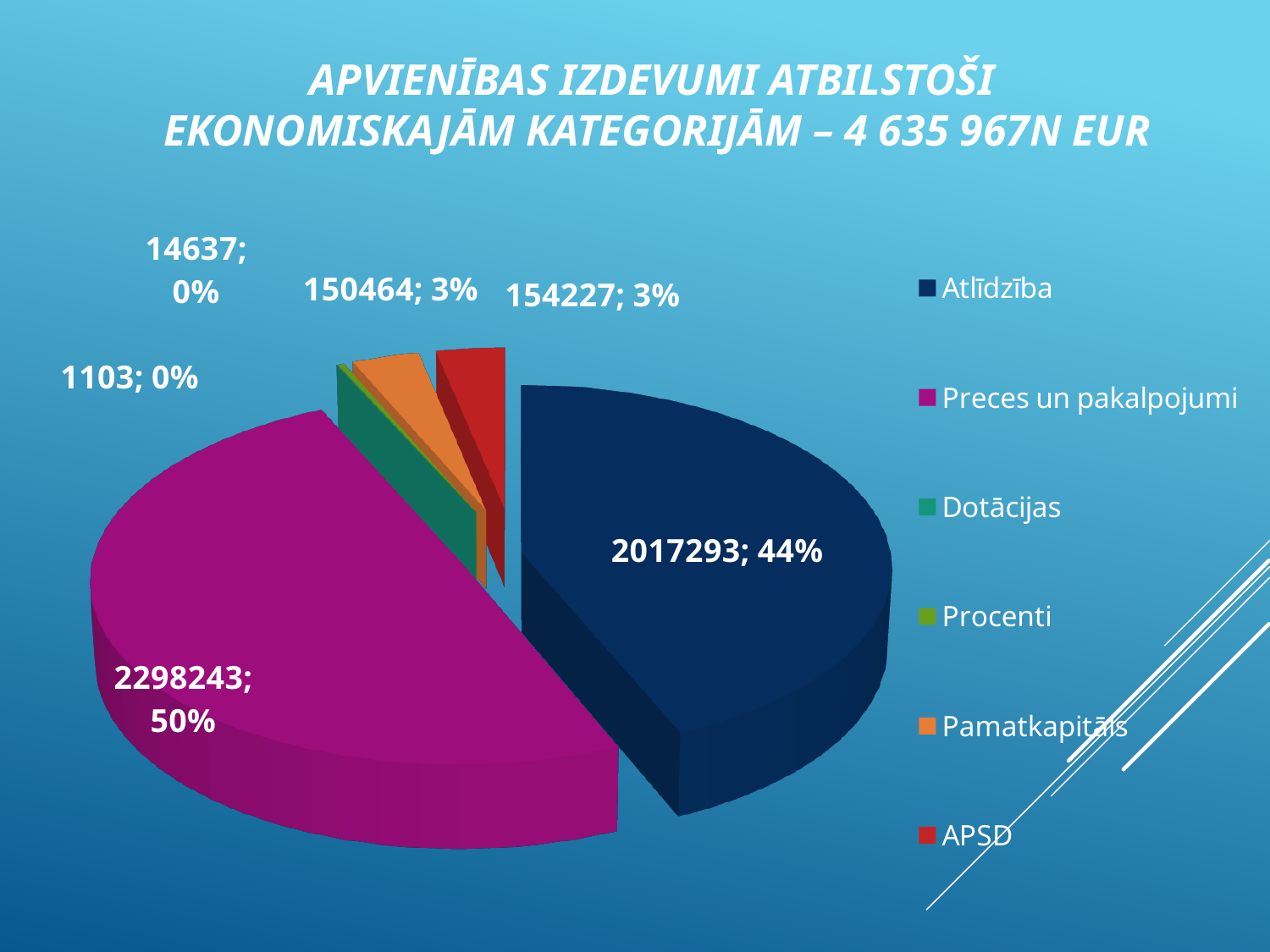
What type of chart is shown on the slide? Pie chart What share of the pie does Preces un pakalpojumi represent? 50% What value is shown for Atlīdzība? 2017293 What is the difference between the values for Preces un pakalpojumi and Atlīdzība? 280950 What total amount in EUR is stated in the chart title? 4 635 967 Which category has the largest slice of the pie? Preces un pakalpojumi What share of the pie does Atlīdzība represent? 44% Which legend entry is shown in dark blue? Atlīdzība How many categories does the pie chart show? 6 What value is shown for Preces un pakalpojumi? 2298243 Which is larger, the value for Atlīdzība or the value for Preces un pakalpojumi? Preces un pakalpojumi What is the smallest value labelled on the pie chart? 1103